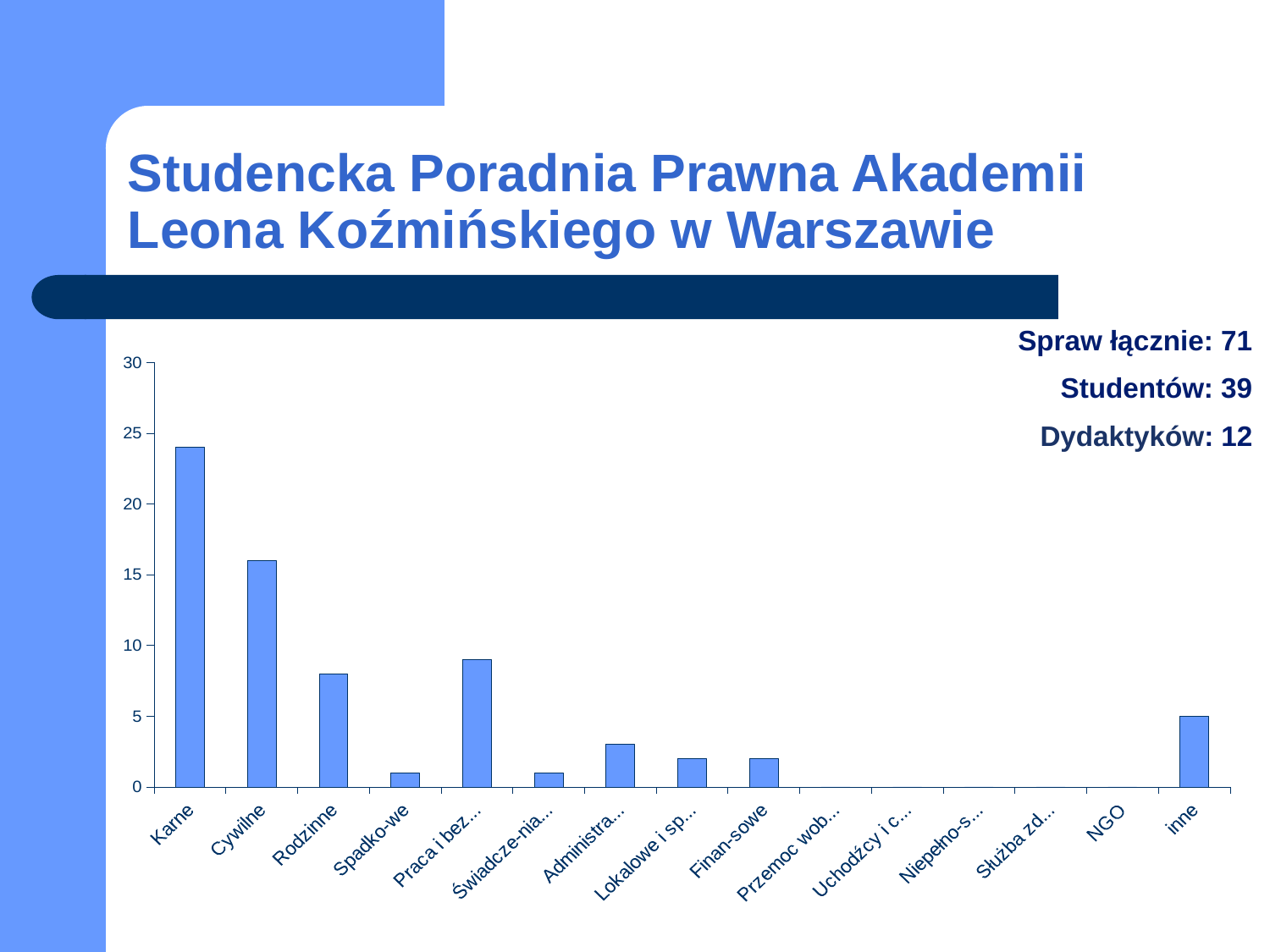
What kind of chart is shown on the slide? bar chart Which is larger, the value for Rodzinne or the value for inne? Rodzinne Is the value for inne greater or less than 10? less Is the value for Rodzinne greater or less than 10? less Which is larger, the value for Karne or the value for Cywilne? Karne Is the value for Spadko-we greater or less than 5? less How many categories are shown on the x axis of the chart? 15 What is the highest value shown on the vertical axis of the chart? 30 Which category has the highest bar in the chart? Karne Does the bar for NGO show any visible value above 0? No